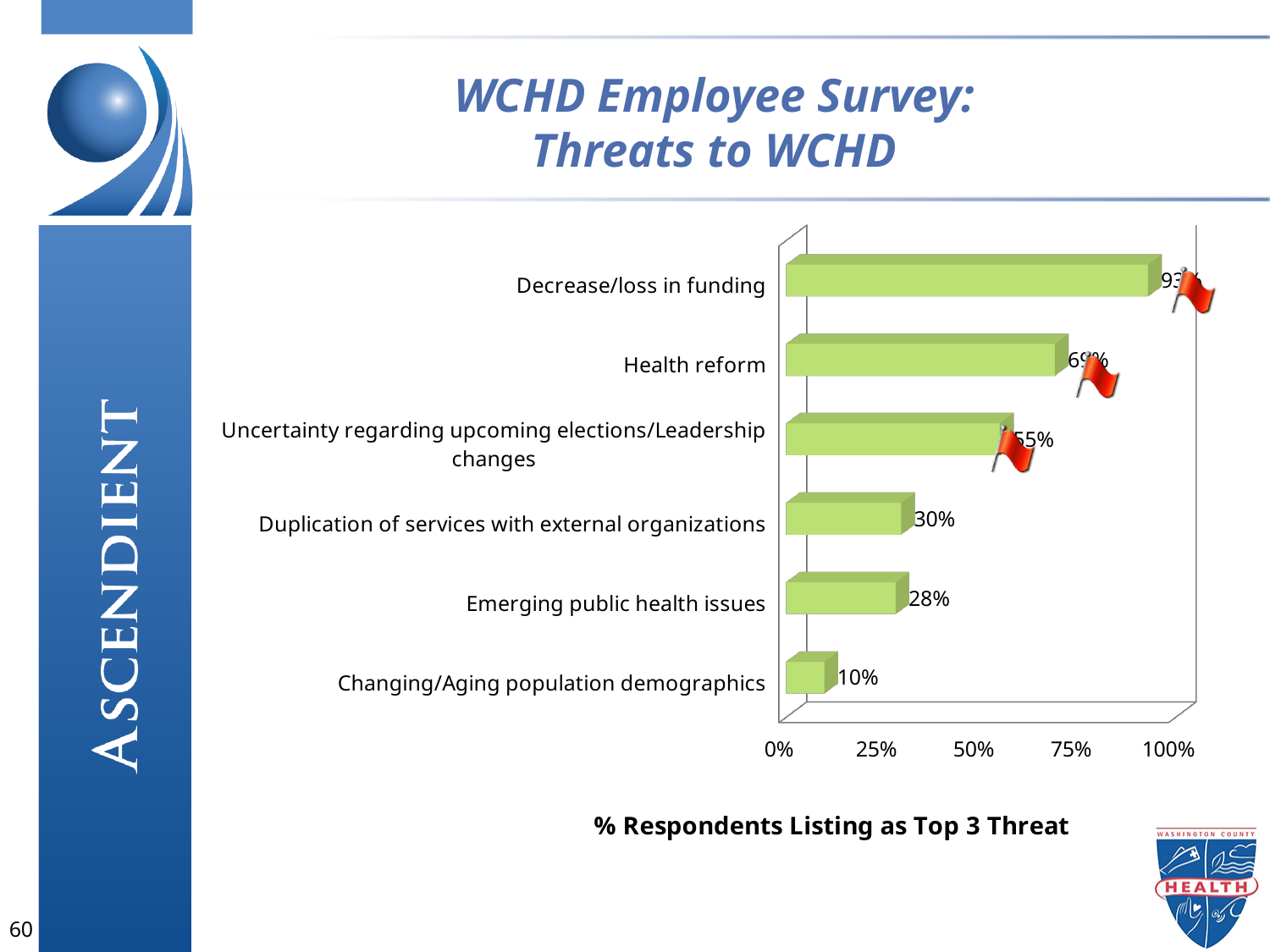
What is the value shown for Uncertainty regarding upcoming elections/Leadership changes? 55% What type of chart is shown on the slide? Bar chart What is the value shown for Changing/Aging population demographics? 10% What is the difference between the values for Duplication of services with external organizations and Changing/Aging population demographics? 20% How many threat categories are shown in the chart? 6 Which is larger, the value for Health reform or the value for Duplication of services with external organizations? Health reform Is the value for Decrease/loss in funding greater or less than 75%? greater What is the value shown for Emerging public health issues? 28% Which threat has the highest percentage of respondents listing it as a top 3 threat? Decrease/loss in funding What percentage of respondents listed Duplication of services with external organizations as a top 3 threat? 30% What is the difference between the values for Uncertainty regarding upcoming elections/Leadership changes and Emerging public health issues? 27% Which threat has the lowest percentage of respondents listing it as a top 3 threat? Changing/Aging population demographics